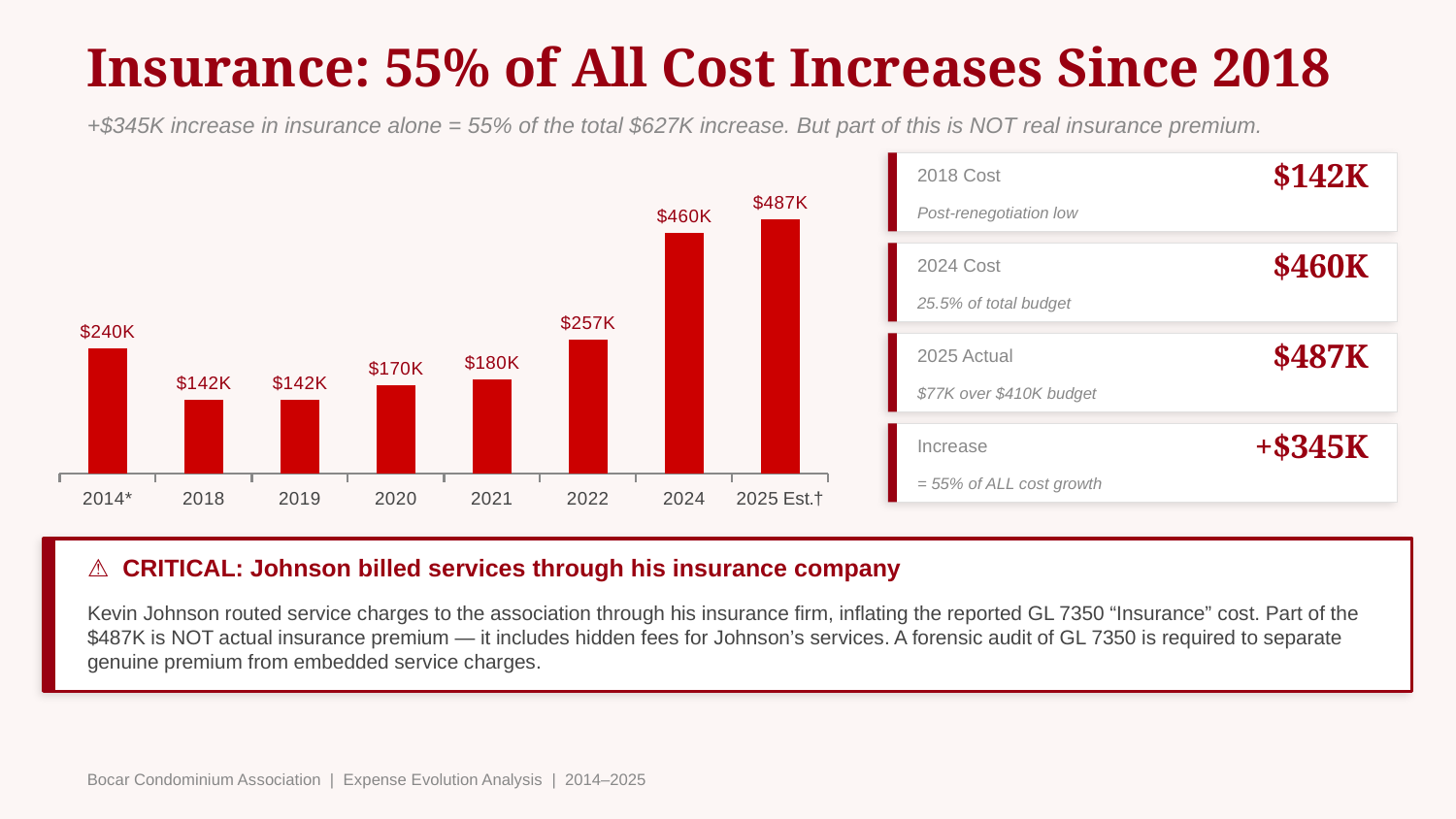
What is the difference between the 2024 and 2022 insurance costs? $203K What is the difference between the 2025 Est.† and 2024 insurance costs? $27K Which year has the highest insurance cost in the chart? 2025 Est.† What is the insurance cost shown for 2021? $180K What type of chart is shown on the slide? Bar chart Do the insurance costs rise or fall from 2018 to 2025 Est.†? Rise What is the insurance cost shown for 2014*? $240K Which years have the lowest insurance cost in the chart? 2018 and 2019 Which is larger, the insurance cost for 2014* or for 2020? 2014* How many years (bars) are shown in the chart? 8 What colour are the bars in the chart? Red What is the insurance cost shown for 2022? $257K